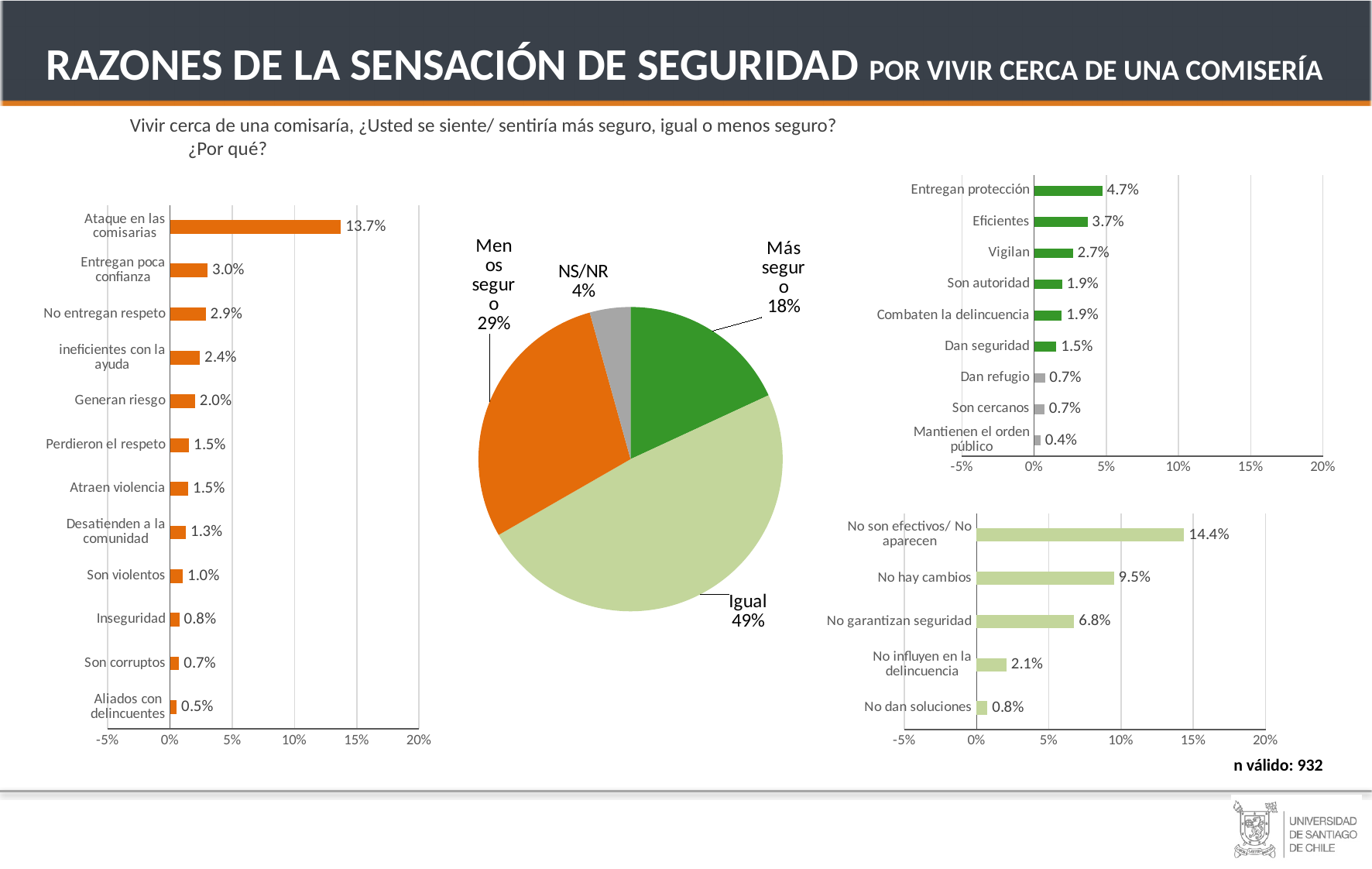
In the light green bar chart at the bottom right of the slide, what is the value for "No hay cambios"? 9.5% In the green bar chart at the top right of the slide, what is the value for "Vigilan"? 2.7% In the pie chart in the centre of the slide, what share is labelled "Igual"? 49% In the orange bar chart on the left of the slide, what is the value for "Ataque en las comisarias"? 13.7% In the pie chart in the centre of the slide, what share is labelled "Más seguro"? 18% In the pie chart in the centre of the slide, which slice is the smallest? NS/NR In the orange bar chart on the left of the slide, what is the difference between "Entregan poca confianza" and "No entregan respeto"? 0.1% In the orange bar chart on the left of the slide, how many categories are shown? 12 In the green bar chart at the top right of the slide, which category has the highest value? Entregan protección How many slices does the pie chart in the centre of the slide have? 4 In the light green bar chart at the bottom right of the slide, which is larger: "No garantizan seguridad" or "No influyen en la delincuencia"? No garantizan seguridad In the orange bar chart on the left of the slide, which category has the lowest value? Aliados con delincuentes